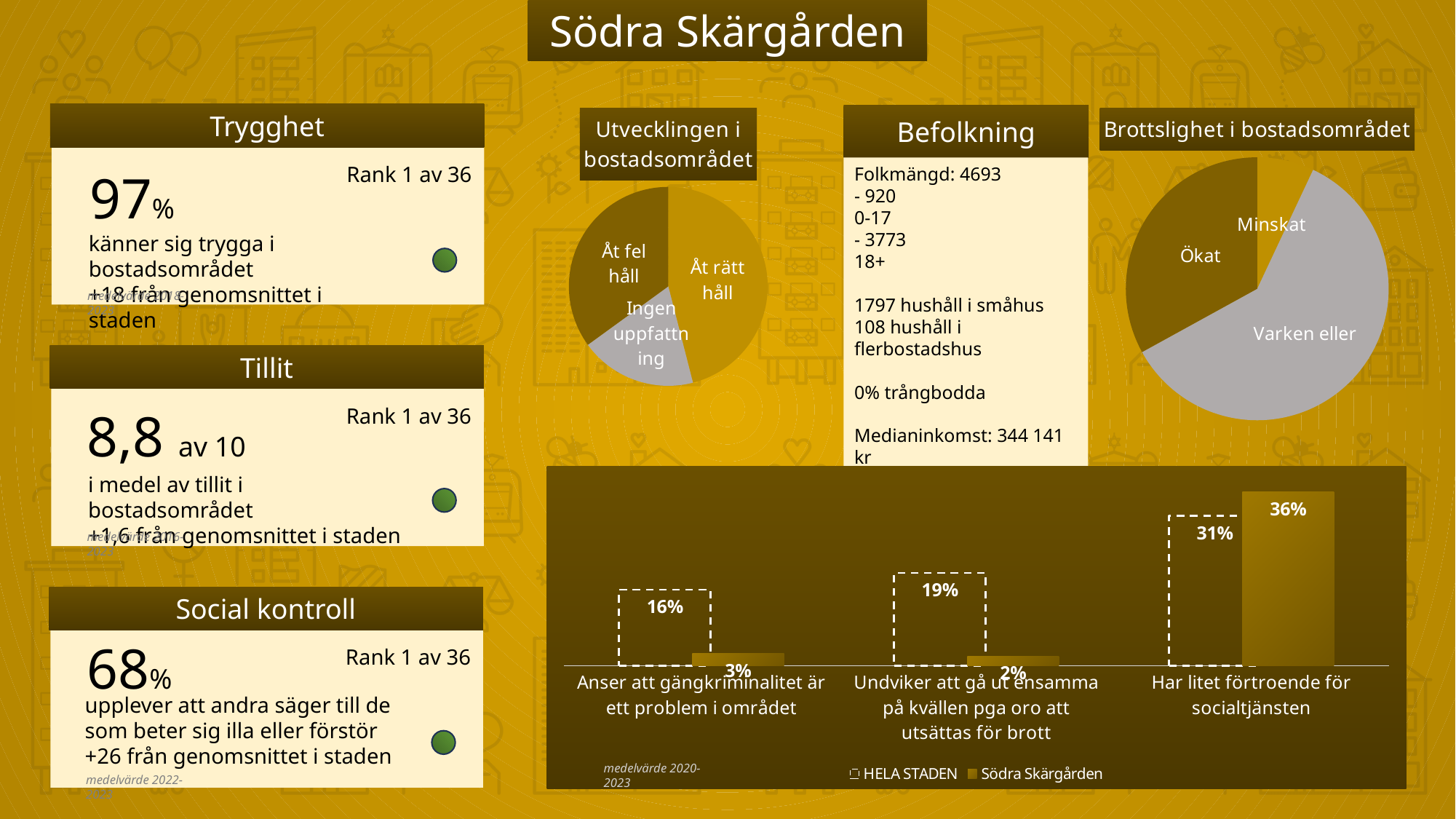
In the bar chart at the bottom of the slide, what is the value for HELA STADEN for 'Har litet förtroende för socialtjänsten'? 31% In the bar chart at the bottom of the slide, which category has the highest value for Södra Skärgården? Har litet förtroende för socialtjänsten In the bar chart at the bottom of the slide, which is larger for 'Har litet förtroende för socialtjänsten': HELA STADEN or Södra Skärgården? Södra Skärgården What kind of chart is 'Brottslighet i bostadsområdet'? Pie chart In the bar chart at the bottom of the slide, what is the value for Södra Skärgården for 'Undviker att gå ut ensamma på kvällen pga oro att utsättas för brott'? 2% In the bar chart at the bottom of the slide, what is the value for HELA STADEN for 'Anser att gängkriminalitet är ett problem i området'? 16% In the bar chart at the bottom of the slide, what is the difference between HELA STADEN and Södra Skärgården for 'Undviker att gå ut ensamma på kvällen pga oro att utsättas för brott'? 17% In the bar chart at the bottom of the slide, what is the value for Södra Skärgården for 'Har litet förtroende för socialtjänsten'? 36% How many slices does the pie chart 'Utvecklingen i bostadsområdet' have? 3 How many series does the legend of the bar chart at the bottom of the slide list? 2 In the bar chart at the bottom of the slide, which category has the lowest value for HELA STADEN? Anser att gängkriminalitet är ett problem i området How many categories are shown in the bar chart at the bottom of the slide? 3